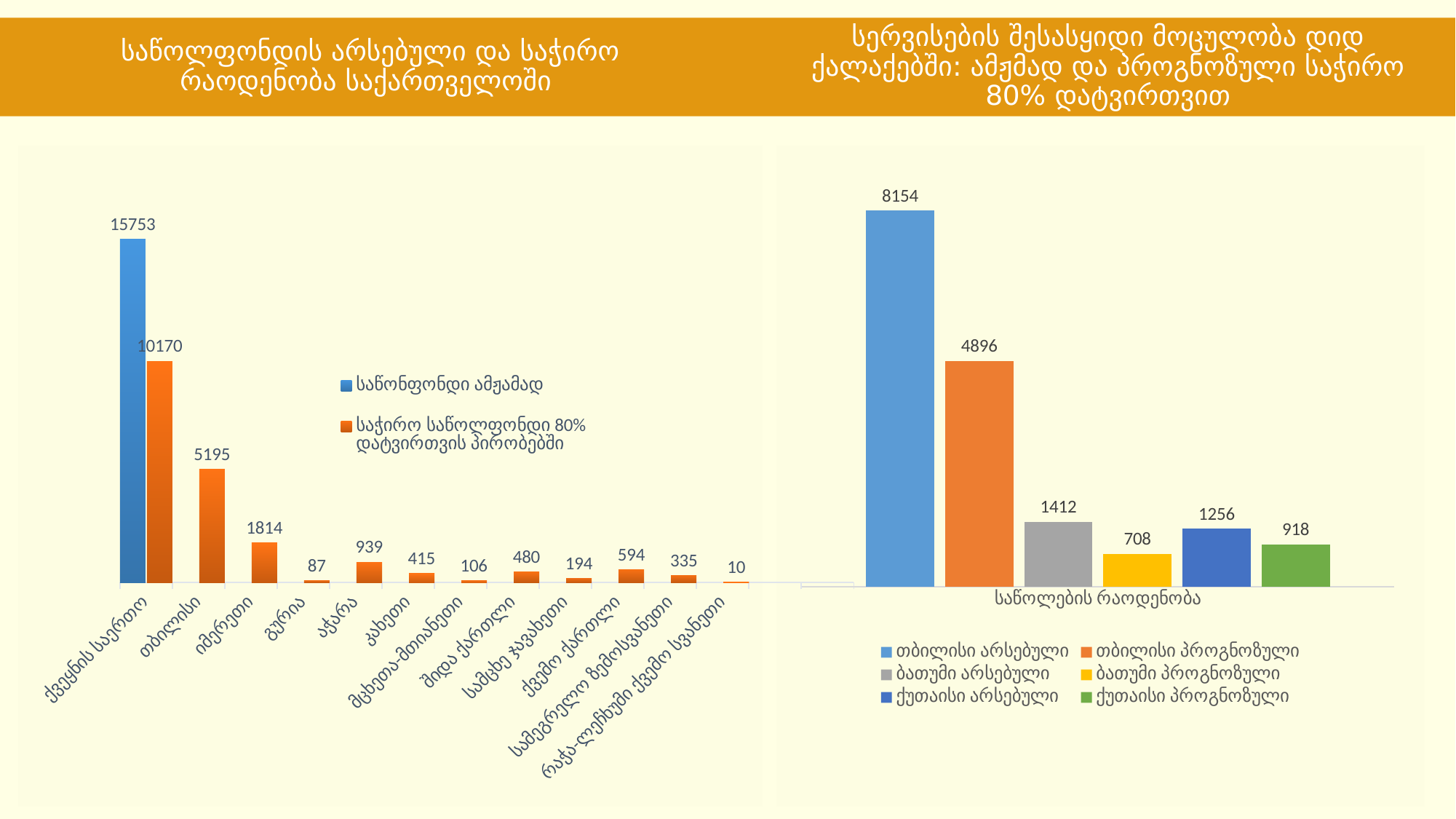
In the left chart, what is the value shown for იმერეთი? 1814 In the left chart, which region (excluding ქვეყნის საერთო) has the lowest value? რაჭა-ლეჩხუმი ქვემო სვანეთი In the left chart, which is larger: the value for აჭარა or the value for ქვემო ქართლი? აჭარა In the left chart, how many series does the legend list? 2 In the right chart, what is the value for თბილისი არსებული? 8154 In the right chart, what is the value for ბათუმი პროგნოზული? 708 In the right chart, what is the difference between ქუთაისი არსებული and ქუთაისი პროგნოზული? 338 In the right chart, how many series does the legend list? 6 In the left chart, what is the value of the orange bar (საჭირო საწოლფონდი 80% დატვირთვის პირობებში) for თბილისი? 5195 What type of chart is the right chart? Bar chart In the left chart, what is the difference between the two bars for ქვეყნის საერთო (15753 and 10170)? 5583 In the left chart, what is the value of the blue bar (საწონფონდი ამჟამად) for ქვეყნის საერთო? 15753